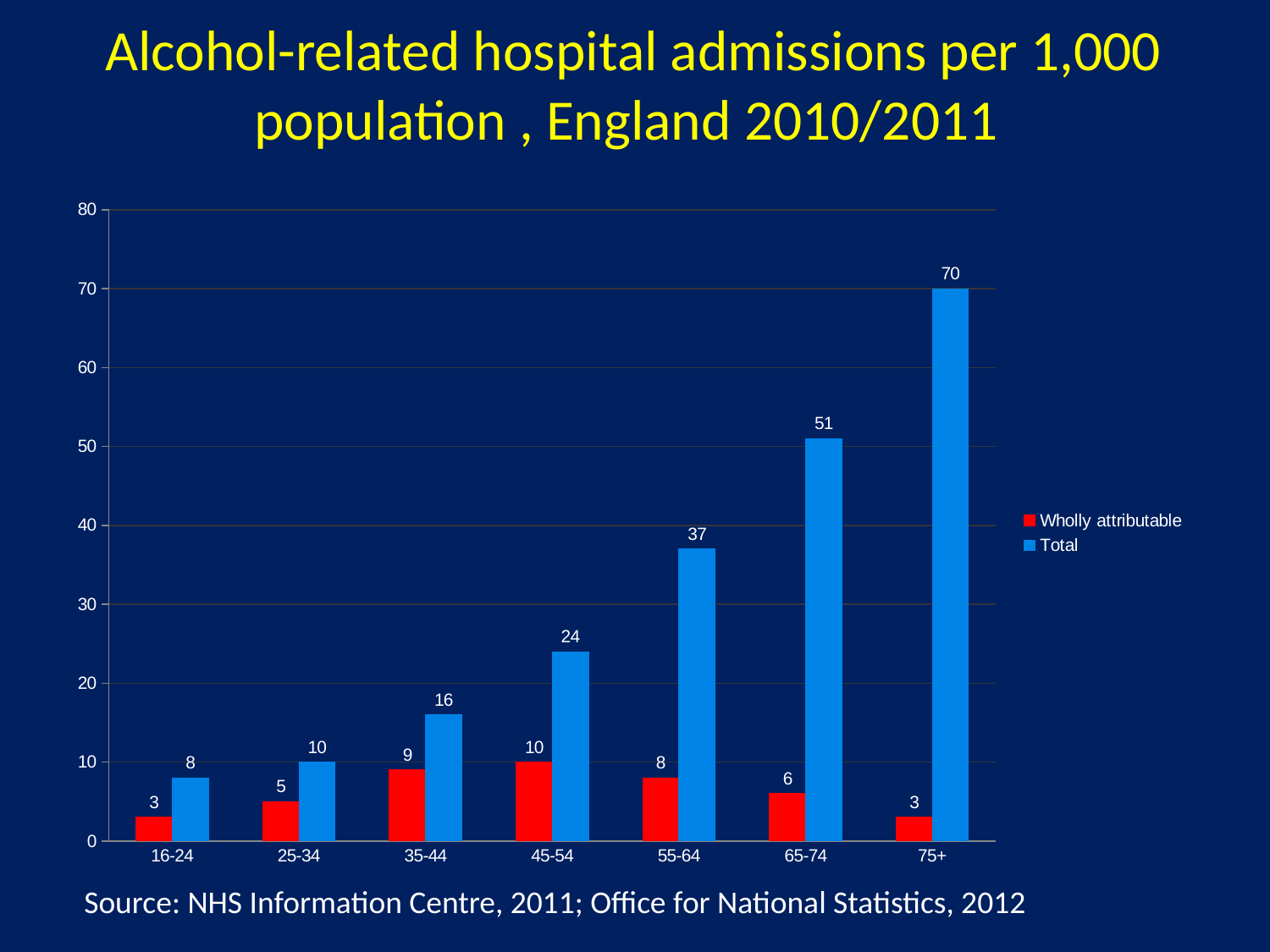
What is the Wholly attributable value for the 45-54 age group? 10 How many age groups are shown on the x axis? 7 Which age group has the lowest Total value? 16-24 What is the Total value for the 55-64 age group? 37 How many series does the legend list? 2 Do the Total values rise or fall as age group increases along the x axis? Rise What is the difference between the Total and Wholly attributable values for the 65-74 age group? 45 Is the Total value for the 65-74 age group greater or less than 40? greater What kind of chart is shown on the slide? Bar chart Which is larger, the Total value for 35-44 or the Total value for 45-54? 45-54 What is the Total value for the 75+ age group? 70 Which age group has the highest Total value? 75+